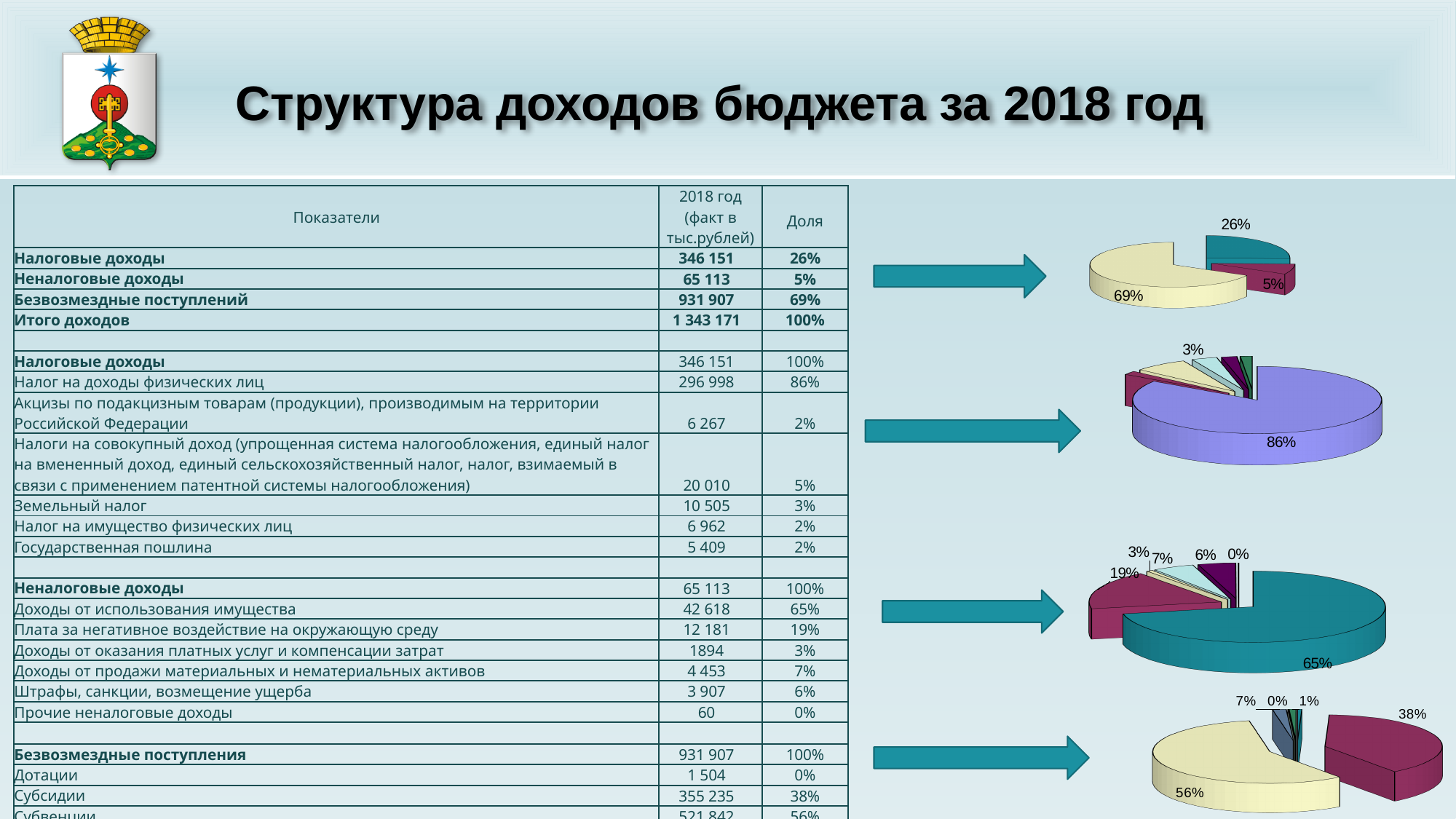
In the second pie chart from the top, what share is shown for the largest slice? 86% In the third pie chart from the top, what share is shown for the largest slice? 65% In the top pie chart, what share is shown for the largest slice? 69% In the top pie chart, how many slices are there? 3 In the bottom pie chart, what is the difference between the 56% slice and the 38% slice? 18 percentage points In the top pie chart, what is the total of the three labelled shares? 100% In the top pie chart, what share is shown for the smallest slice? 5% In the third pie chart from the top, what is the difference between the 65% slice and the 19% slice? 46 percentage points In the third pie chart from the top, how many percentage labels are shown? 6 What kind of chart is the top chart on the right side of the slide? pie chart How many pie charts are shown on the slide? 4